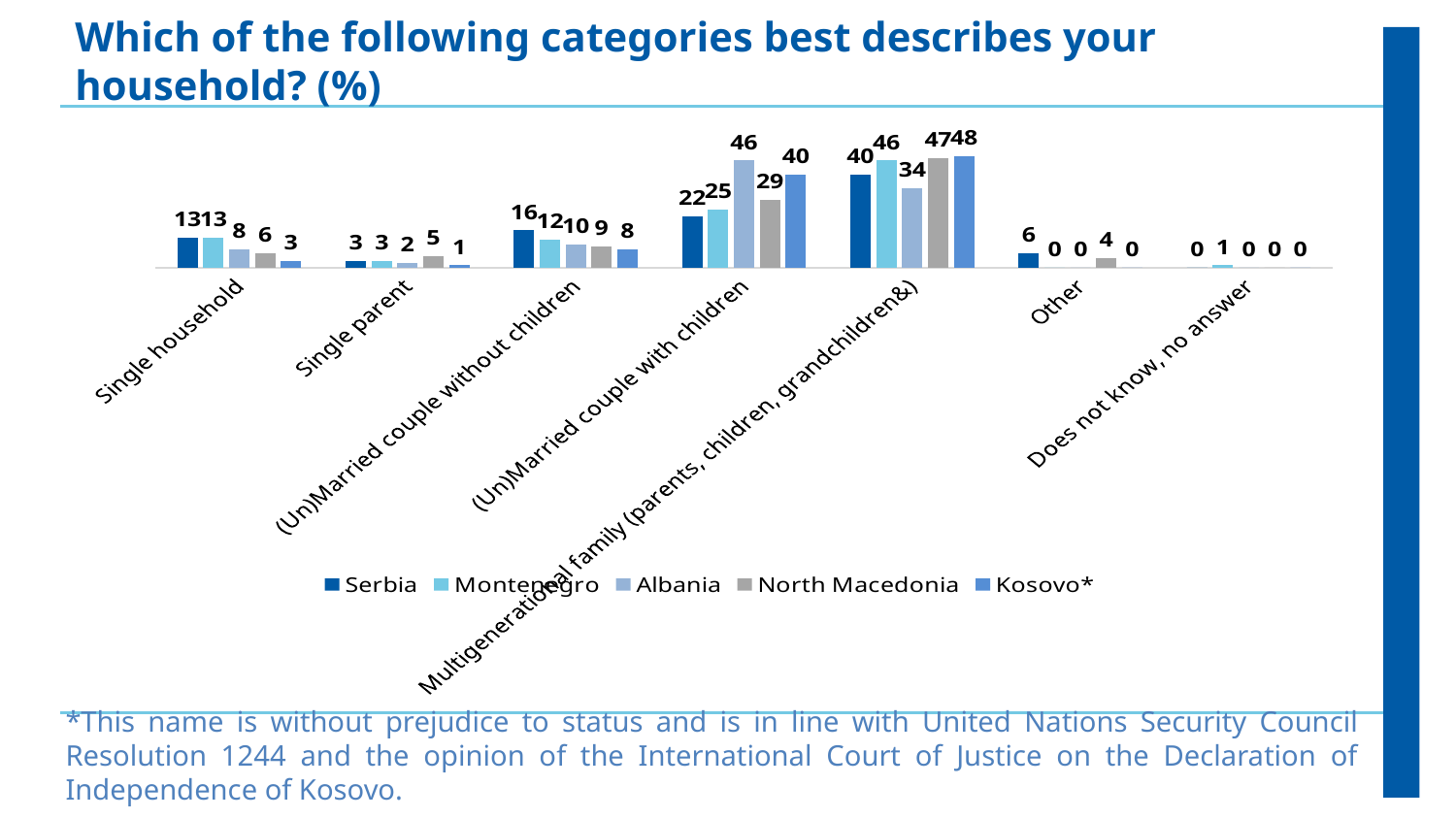
Which country has the highest value in the (Un)Married couple without children category? Serbia What kind of chart is shown on the slide? Bar chart How many series does the legend list? 5 Which country has the lowest value in the (Un)Married couple with children category? Serbia What is the value for Kosovo* in the Multigenerational family category? 48 Which is larger in the Multigenerational family category: Montenegro or Albania? Montenegro What is the value for Albania in the (Un)Married couple with children category? 46 What is the value for North Macedonia in the Single parent category? 5 What is the value for Montenegro in the Does not know, no answer category? 1 What is the value for Serbia in the Single household category? 13 How many household categories are shown on the x axis? 7 What is the difference between Albania and Serbia in the (Un)Married couple with children category? 24